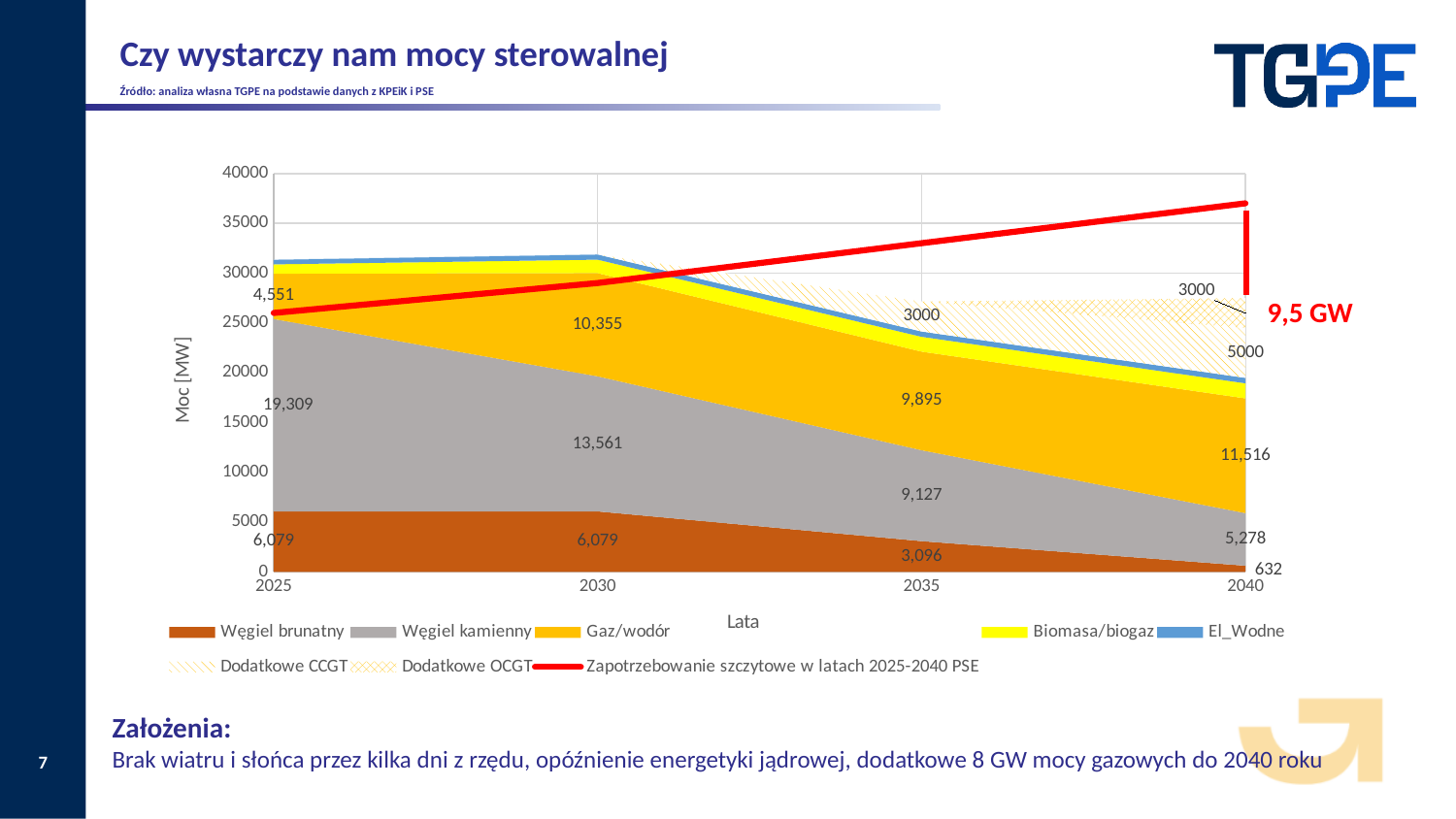
In which year is the value for Węgiel brunatny the lowest? 2040 What is the difference between the Węgiel kamienny values in 2025 and 2040? 14,031 What is the value for Węgiel kamienny in 2025? 19,309 What is the value for Węgiel brunatny in 2035? 3,096 In which year is the value for Węgiel kamienny the highest? 2025 What is the label of the y axis? Moc [MW] What is the value for Gaz/wodór in 2040? 11,516 How many years are shown on the x axis? 4 In 2030, which is larger: Gaz/wodór or Węgiel kamienny? Węgiel kamienny Is the value of the red line (Zapotrzebowanie szczytowe) in 2040 greater or less than 35000? greater How many series does the legend list? 8 Does the value for Gaz/wodór rise or fall from 2025 to 2040? rise